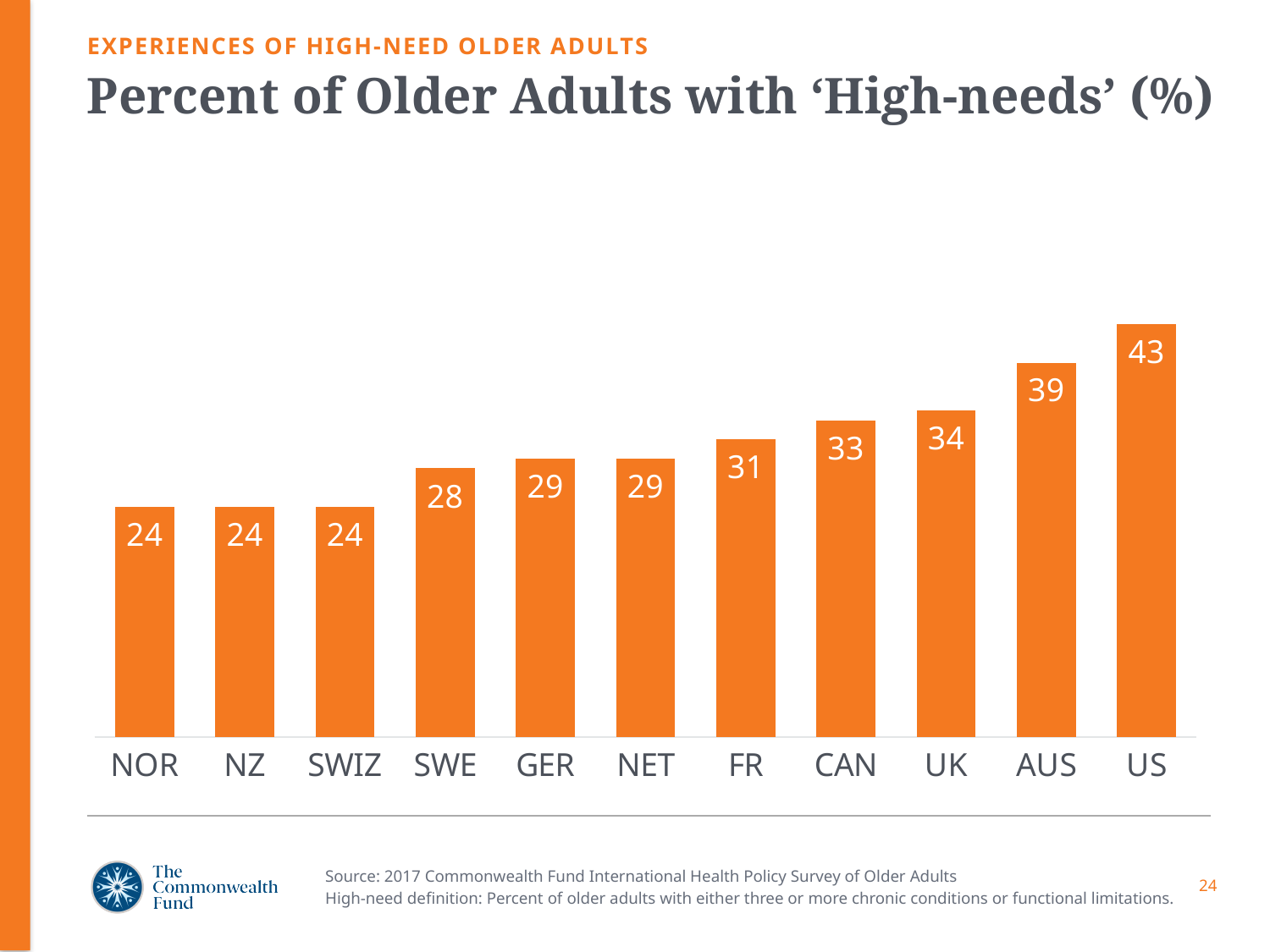
Which country has the highest percent of older adults with high needs? US What is the value for SWE? 28 Which is larger, the value for FR or the value for GER? FR How many countries are shown in the chart? 11 What is the difference between the values for the US and AUS? 4 What is the value for CAN? 33 What kind of chart is shown on the slide? Bar chart Do the values rise or fall from left to right across the countries? Rise What is the difference between the values for the UK and NOR? 10 What is the value for the US? 43 What is the title of the chart? Percent of Older Adults with 'High-needs' (%) What is the lowest value shown in the chart? 24